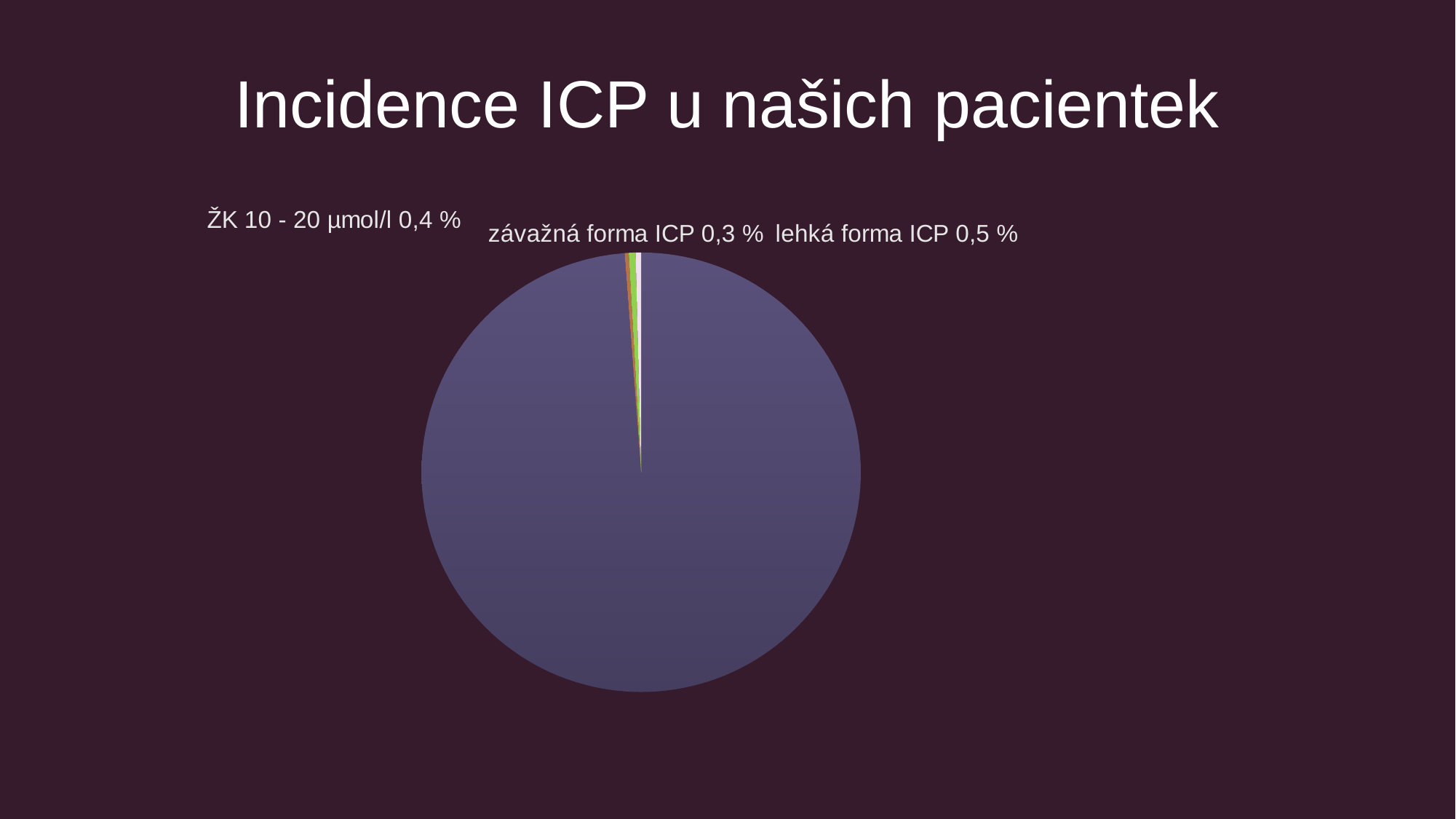
How many labeled categories are shown on the pie chart? 3 Which of the labeled categories has the lowest value? závažná forma ICP Is the value for lehká forma ICP greater or less than 1 %? less What type of chart is shown on the slide? pie chart What value is shown for lehká forma ICP? 0,5 % Which of the labeled categories has the highest value? lehká forma ICP Which is larger, the value for ŽK 10 - 20 µmol/l or the value for závažná forma ICP? ŽK 10 - 20 µmol/l What is the difference between the values for lehká forma ICP and ŽK 10 - 20 µmol/l? 0,1 % What value is shown for ŽK 10 - 20 µmol/l? 0,4 % What is the difference between the values for lehká forma ICP and závažná forma ICP? 0,2 % What is the title of the chart? Incidence ICP u našich pacientek What value is shown for závažná forma ICP? 0,3 %